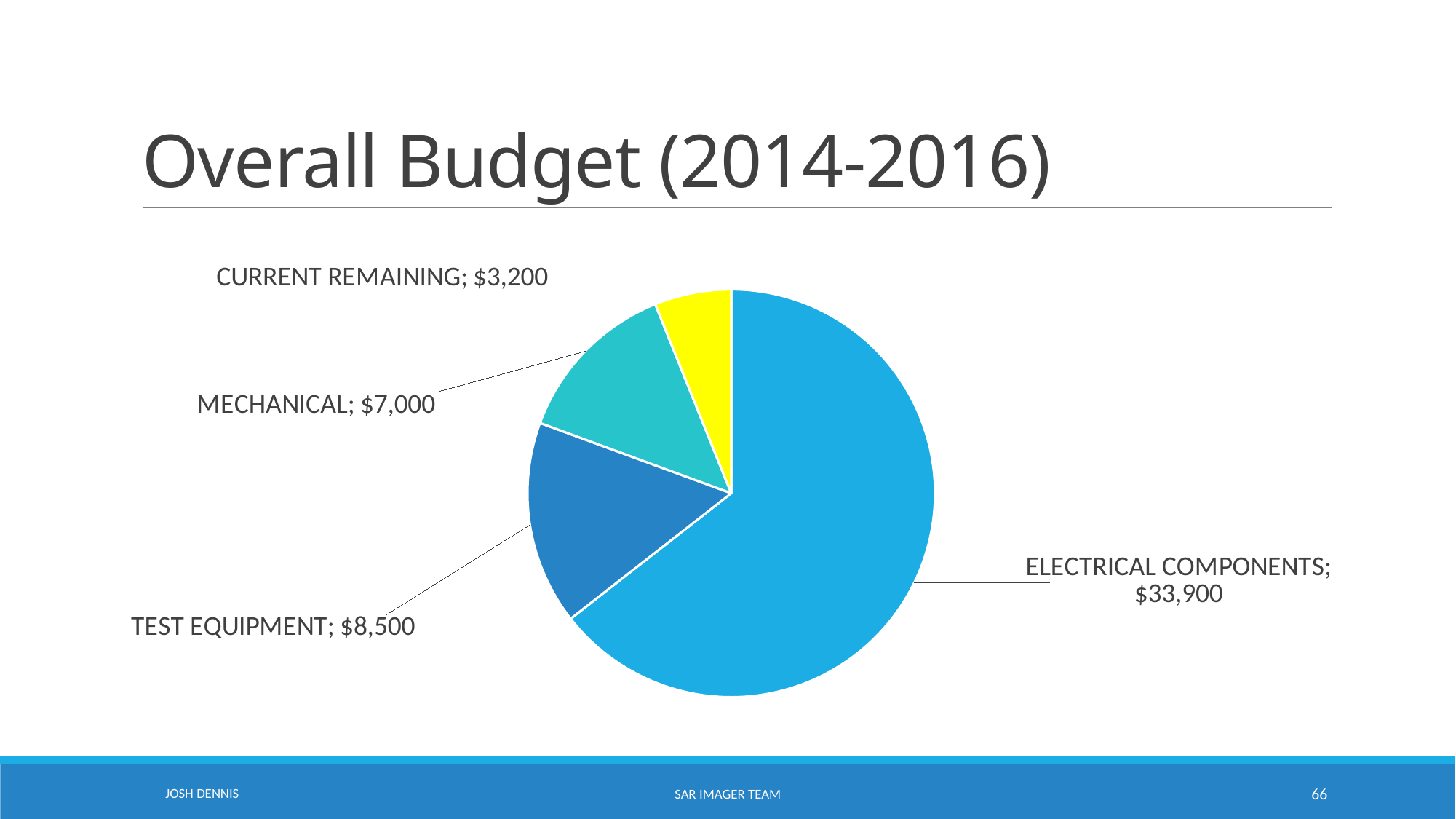
What is the difference between Electrical Components and Test Equipment? $25,400 What is the value for Mechanical? $7,000 What is the title of the chart on the slide? Overall Budget (2014-2016) What is the value for Test Equipment? $8,500 Which category has the smallest slice of the pie? Current Remaining Which category has the largest slice of the pie? Electrical Components Which is larger, Mechanical or Current Remaining? Mechanical What is the difference between Test Equipment and Mechanical? $1,500 What kind of chart is shown on the slide? Pie chart What is the value for Electrical Components? $33,900 What is the value for Current Remaining? $3,200 How many slices does the pie chart have? 4